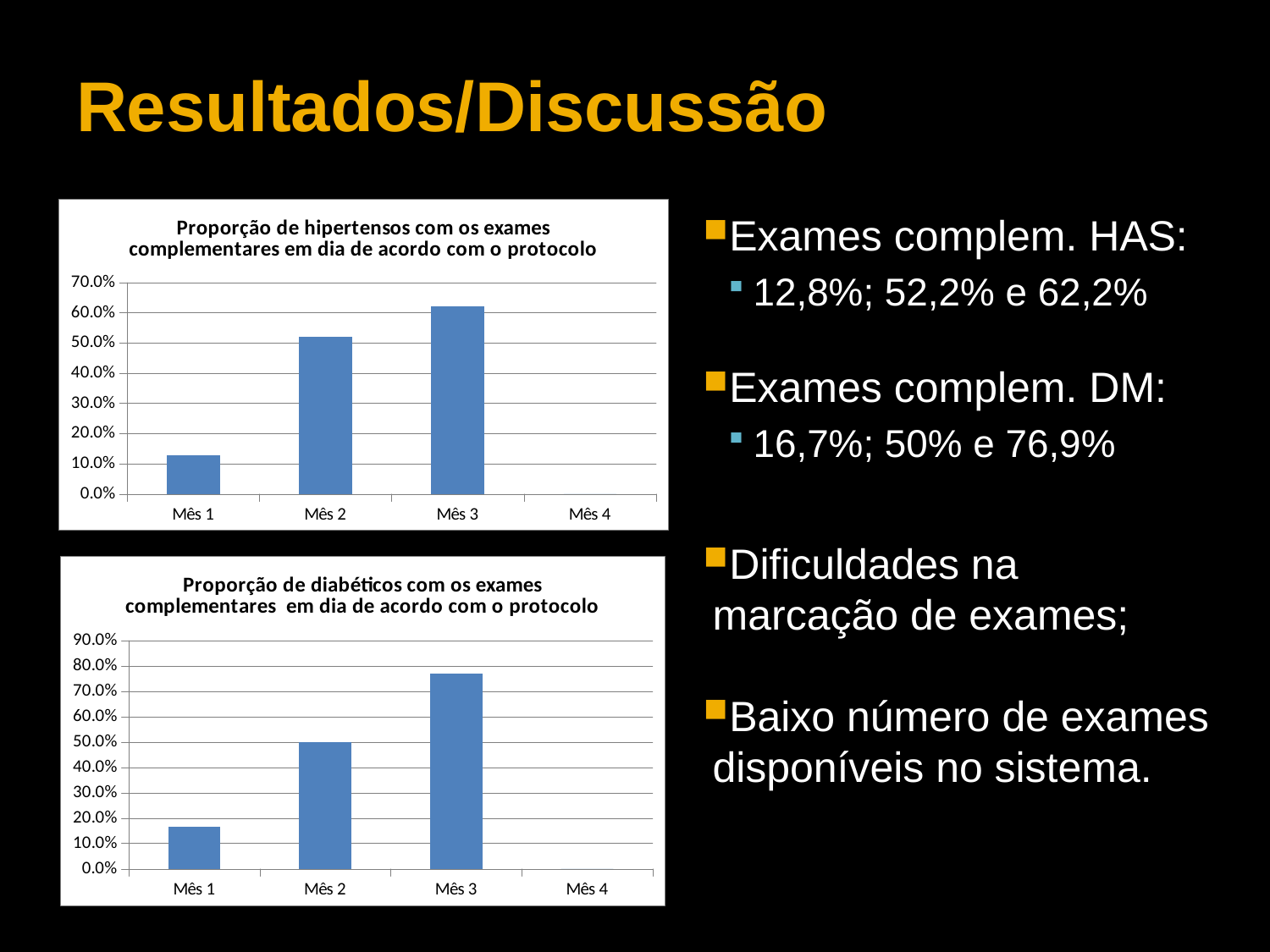
In the bottom chart (diabéticos), which month has the tallest bar? Mês 3 What kind of chart is the top chart, 'Proporção de hipertensos com os exames complementares em dia de acordo com o protocolo'? Bar chart In the bottom chart (diabéticos), is the value for Mês 3 greater or less than 70.0%? greater In the top chart (hipertensos), which month has the tallest bar? Mês 3 What is the highest value shown on the y axis of the bottom chart (diabéticos)? 90.0% In the top chart (hipertensos), which is larger, the value for Mês 1 or the value for Mês 2? Mês 2 In the bottom chart (diabéticos), do the values rise or fall from Mês 1 to Mês 3? rise In the top chart (hipertensos), is the value for Mês 1 greater or less than 20.0%? less In the top chart (hipertensos), is the value for Mês 3 greater or less than 50.0%? greater In the bottom chart (diabéticos), what is the value for Mês 2? 50.0% How many month categories are shown on the x axis of the top chart (hipertensos)? 4